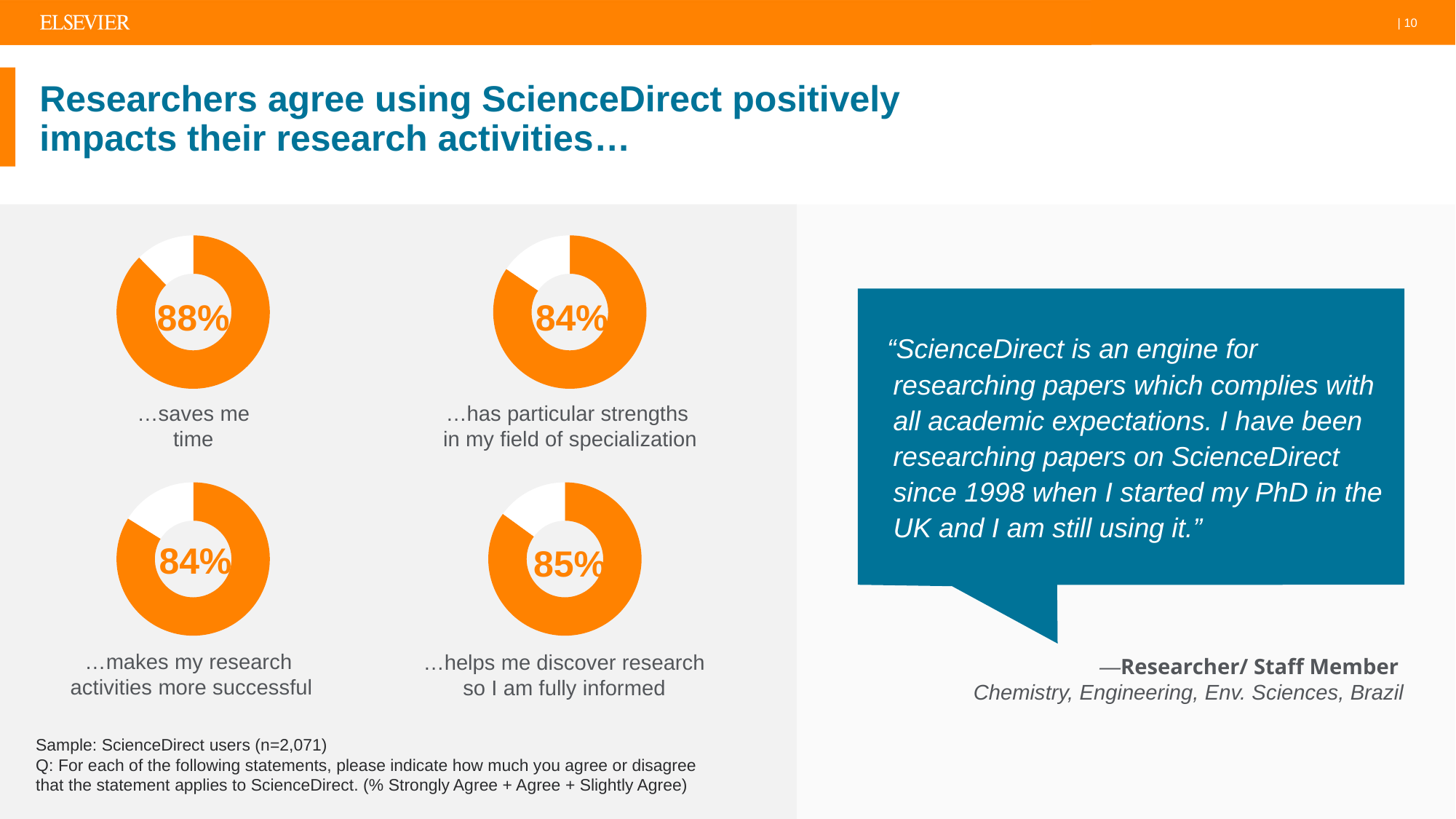
What type of chart is used to display the agreement percentages? Donut (pie) chart How many donut charts are shown on the slide? 4 What percentage of researchers agree that ScienceDirect makes their research activities more successful? 84% Which has a higher agreement percentage: 'saves me time' or 'helps me discover research so I am fully informed'? …saves me time What percentage of researchers agree that ScienceDirect has particular strengths in their field of specialization? 84% Which two statements are tied for the lowest agreement percentage? …has particular strengths in my field of specialization and …makes my research activities more successful What colour is used for the filled portion of the donut charts? Orange What percentage of researchers agree that ScienceDirect saves them time? 88% What is the difference in percentage points between the 'saves me time' chart and the 'makes my research activities more successful' chart? 4 percentage points What percentage of researchers agree that ScienceDirect helps them discover research so they are fully informed? 85% What is the sample size stated for the survey shown in the charts? n=2,071 Which statement has the highest agreement percentage among the four donut charts? …saves me time